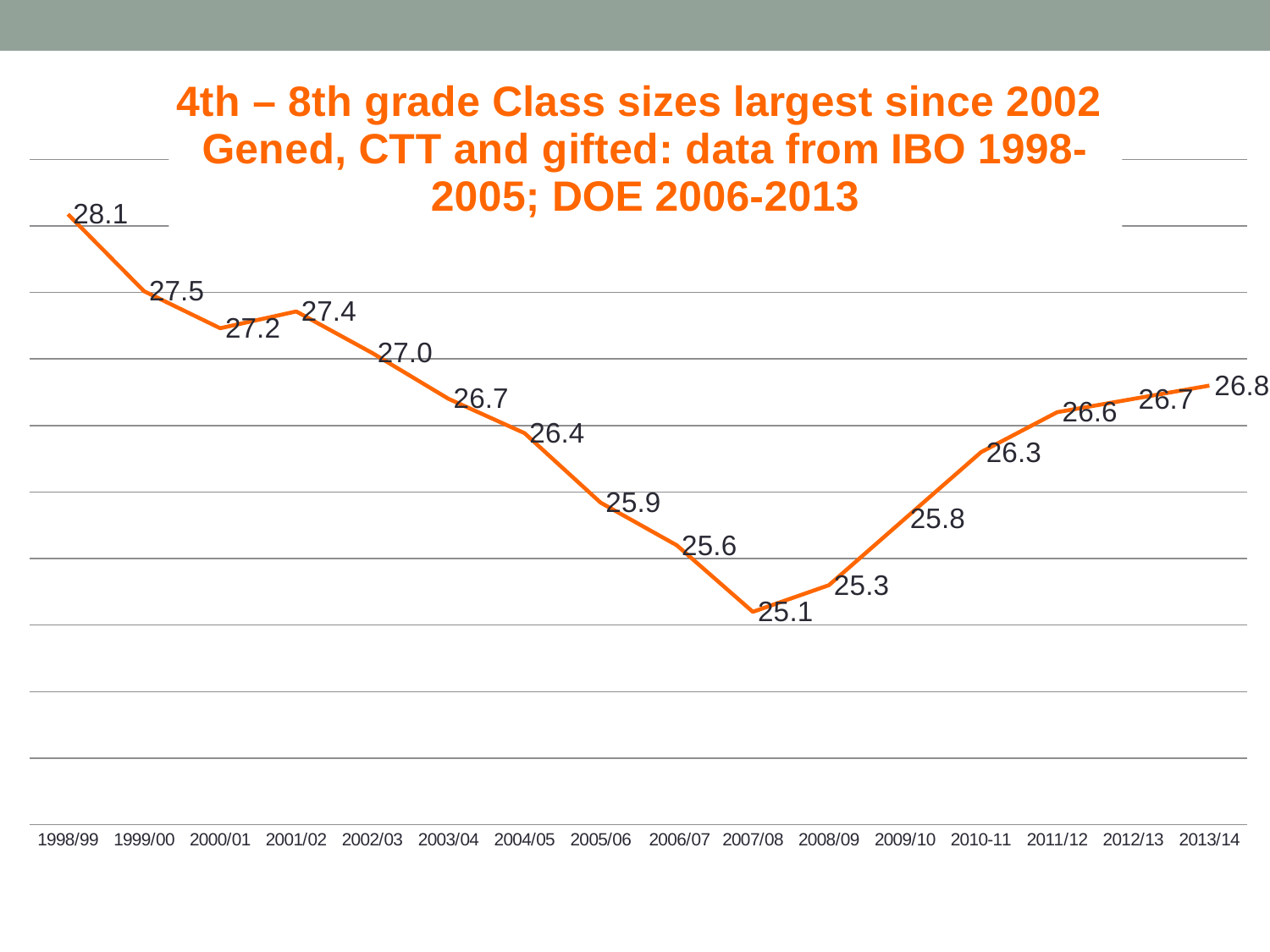
What is the difference between the class size values for 2013/14 and 2010-11? 0.5 What is the class size value for 2013/14? 26.8 How many school years are plotted on the x axis? 16 What kind of chart is shown on the slide? line chart What is the class size value for 1998/99? 28.1 What is the difference between the class size values for 1998/99 and 2007/08? 3.0 What is the class size value for 2003/04? 26.7 Which is larger, the class size value for 2001/02 or for 2000/01? 2001/02 Which school year has the lowest class size value? 2007/08 What is the class size value for 2007/08? 25.1 Do the values rise or fall from 2007/08 to 2013/14? rise Which school year has the highest class size value? 1998/99